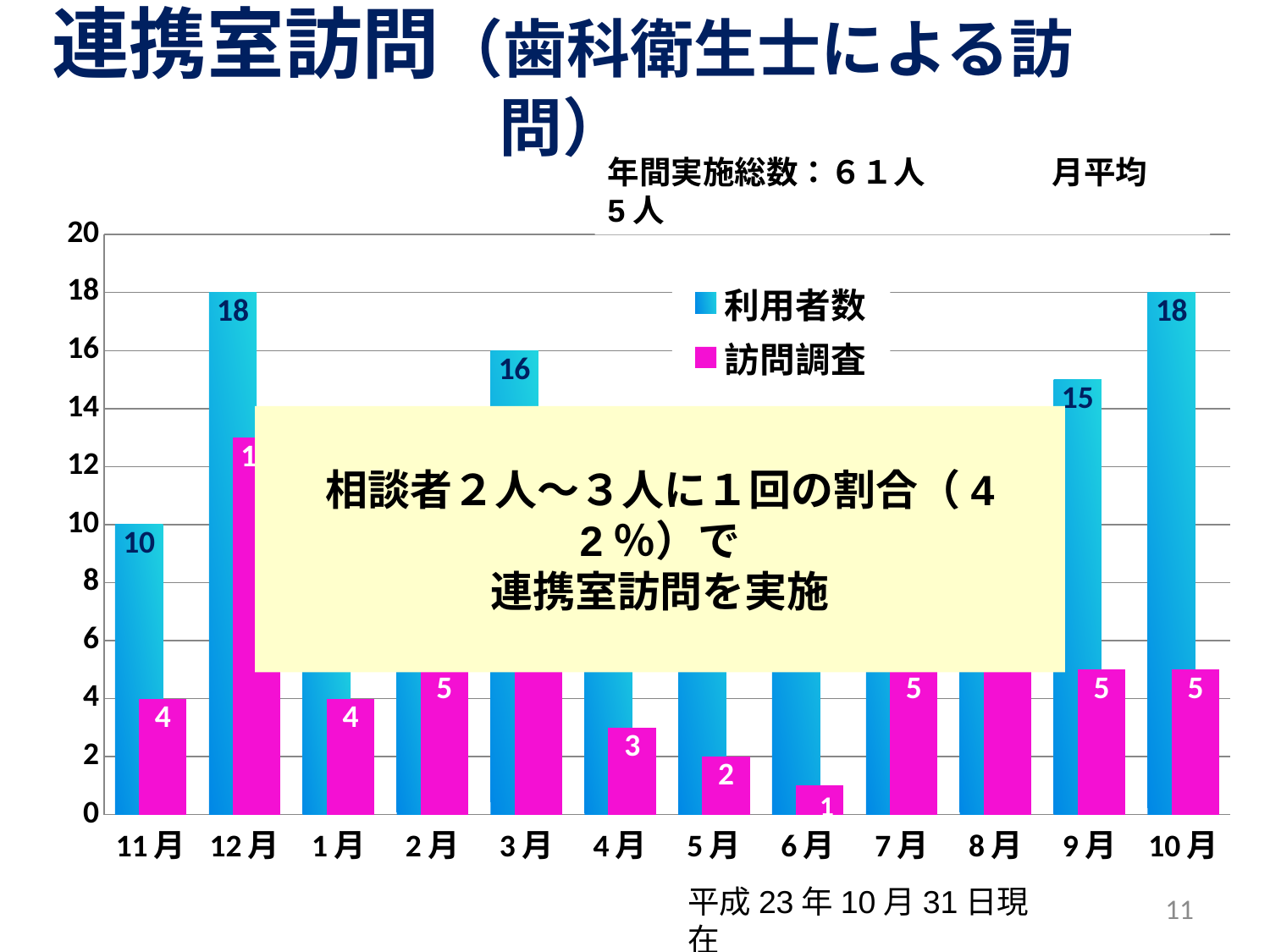
How many series does the legend list? 2 Which is larger, the 利用者数 value for 11月 or for 3月? 3月 Which month has the lowest value for 訪問調査? 6月 What is the value of 利用者数 for 11月? 10 Is the value of 訪問調査 for 12月 greater or less than 10? greater What is the value of 利用者数 for 9月? 15 What is the value of 訪問調査 for 6月? 1 What kind of chart is shown on the slide? bar chart What is the difference between 利用者数 and 訪問調査 for 10月? 13 How many months are shown on the x axis? 12 What are the two series named in the legend? 利用者数 and 訪問調査 What is the value of 訪問調査 for 4月? 3